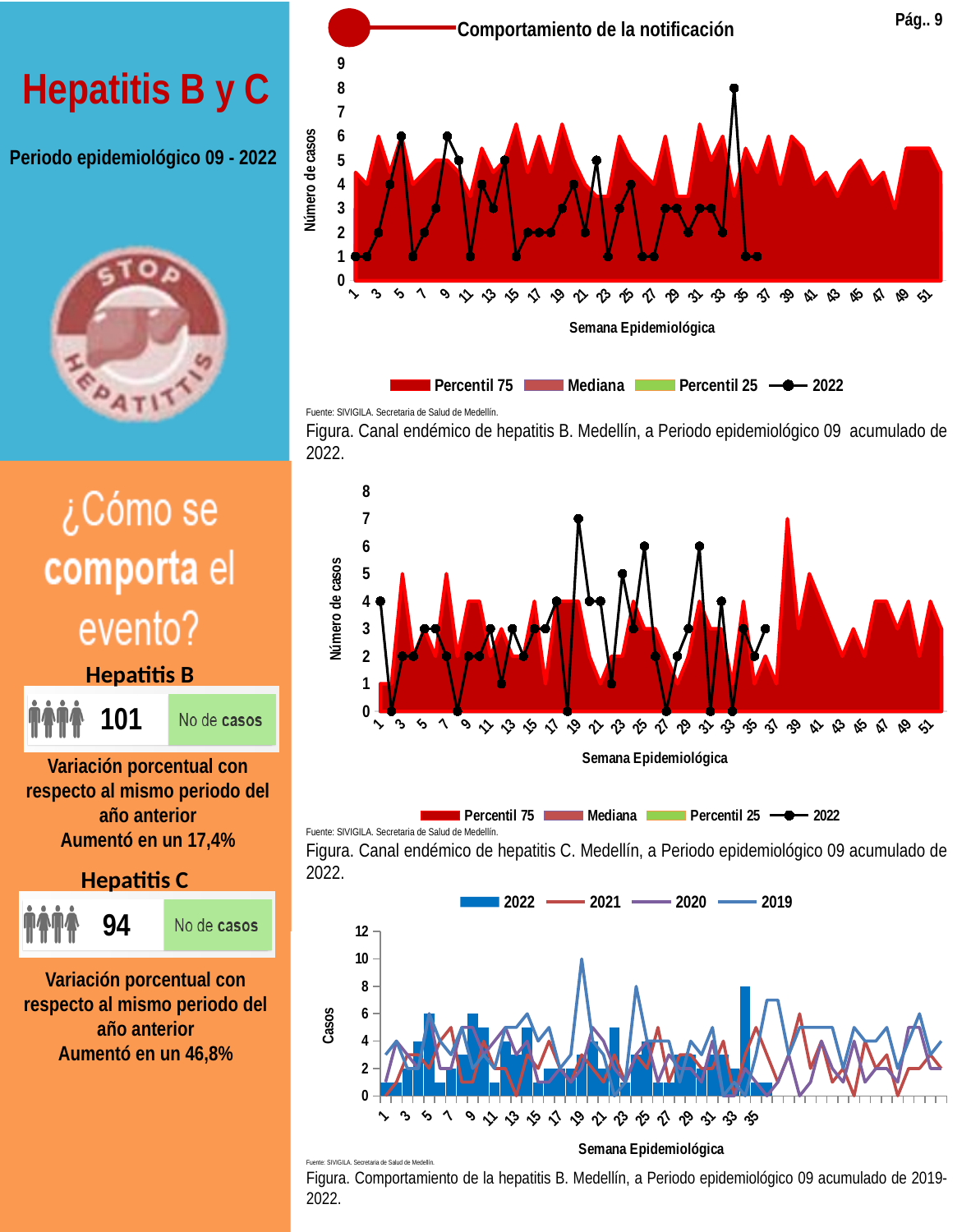
In the bottom chart (Comportamiento de la hepatitis B 2019-2022), how many series does the legend list? 4 In the hepatitis B endemic channel chart (top chart), how many cases does the 2022 line show at epidemiological week 34? 8 In the hepatitis B endemic channel chart (top chart), at which epidemiological week does the 2022 line reach its highest value? 34 In the hepatitis C endemic channel chart (middle chart), how many cases does the 2022 line show at epidemiological week 19? 7 In the hepatitis C endemic channel chart (middle chart), how many cases does the 2022 line show at epidemiological week 1? 4 In the hepatitis C endemic channel chart (middle chart), is the 2022 value at week 25 greater or less than the 2022 value at week 26? greater In the hepatitis C endemic channel chart (middle chart), at which epidemiological week does the 2022 line reach its highest value? 19 In the bottom chart (Comportamiento de la hepatitis B 2019-2022), which series is drawn as bars? 2022 In the bottom chart (Comportamiento de la hepatitis B 2019-2022), is the 2019 value at week 19 greater or less than 8? greater In the hepatitis B endemic channel chart (top chart), what is the highest value shown on the y axis? 9 In the hepatitis B endemic channel chart (top chart), how many series does the legend list? 4